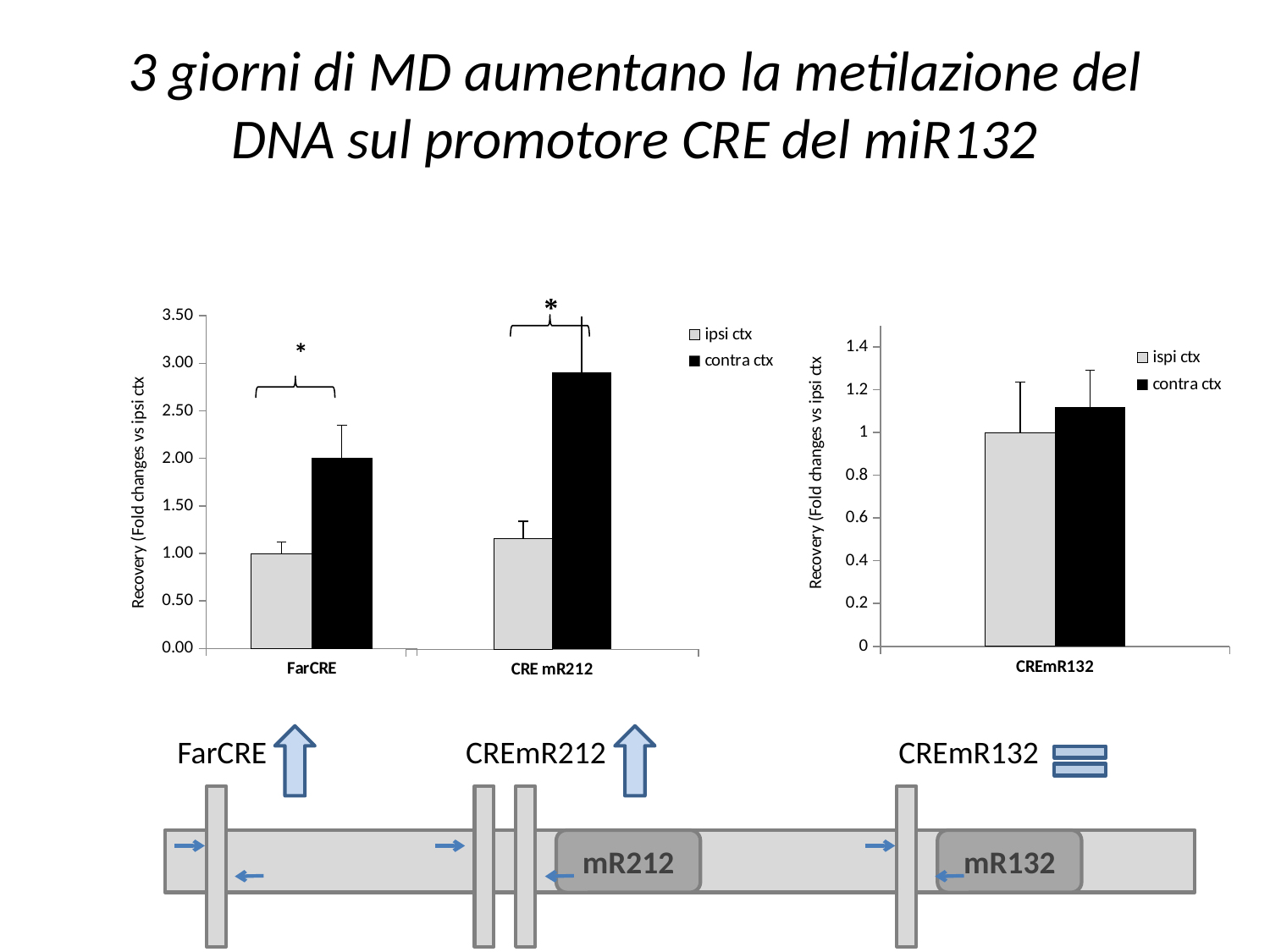
How many categories are shown on the x axis of the left chart? 2 What is the only category shown on the x axis of the right chart? CREmR132 In the left chart, which series has the larger value for FarCRE, ipsi ctx or contra ctx? contra ctx In the right chart, is the ispi ctx value for CREmR132 greater or less than 0.8? greater What is the y-axis label of the right chart? Recovery (Fold changes vs ipsi ctx In the left chart, is the contra ctx value for CRE mR212 greater or less than 2.50? greater In the left chart, is the ipsi ctx value for CRE mR212 greater or less than 1.50? less How many series does the legend of the left chart list? 2 What kind of chart is the left chart on the slide? bar chart In the left chart, which category has the highest contra ctx bar? CRE mR212 In the left chart, what is the ipsi ctx value for FarCRE? 1.00